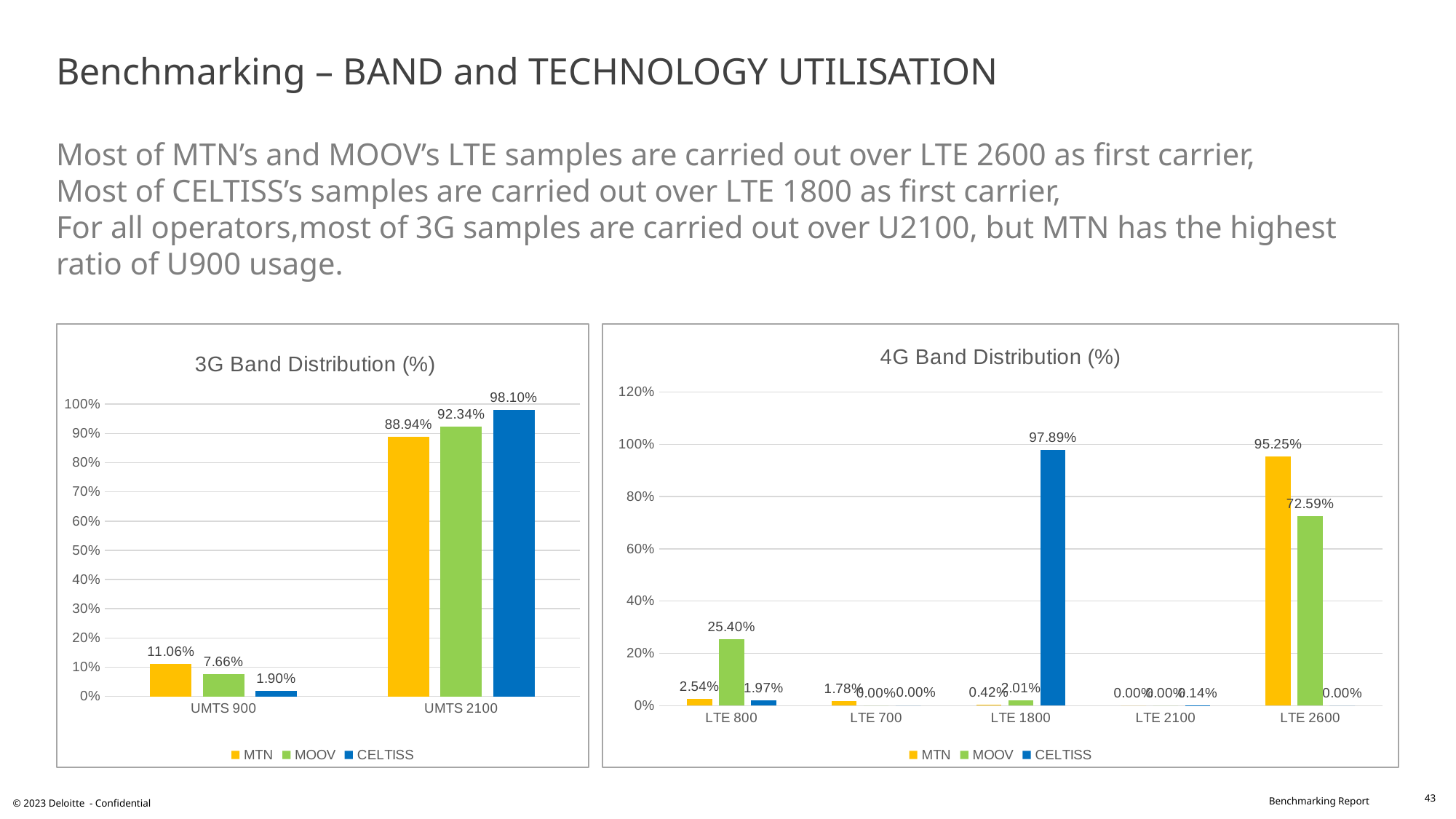
In the 4G Band Distribution (%) chart, what is the value for MOOV at LTE 800? 25.40% In the 3G Band Distribution (%) chart, what is the value for CELTISS at UMTS 2100? 98.10% In the 4G Band Distribution (%) chart, how many series does the legend list? 3 In the 3G Band Distribution (%) chart, which operator has the highest value at UMTS 2100? CELTISS In the 3G Band Distribution (%) chart, what is the difference between MOOV's and MTN's values at UMTS 2100? 3.40 percentage points What kind of chart is the 4G Band Distribution (%) chart? Bar chart In the 3G Band Distribution (%) chart, what is the value for MTN at UMTS 900? 11.06% In the 4G Band Distribution (%) chart, which is larger at LTE 2600: MTN or MOOV? MTN In the 4G Band Distribution (%) chart, what is the difference between MTN's and MOOV's values at LTE 2600? 22.66 percentage points In the 3G Band Distribution (%) chart, how many band categories are shown on the x axis? 2 In the 4G Band Distribution (%) chart, which band has the highest value for MTN? LTE 2600 In the 4G Band Distribution (%) chart, what is the value for CELTISS at LTE 1800? 97.89%